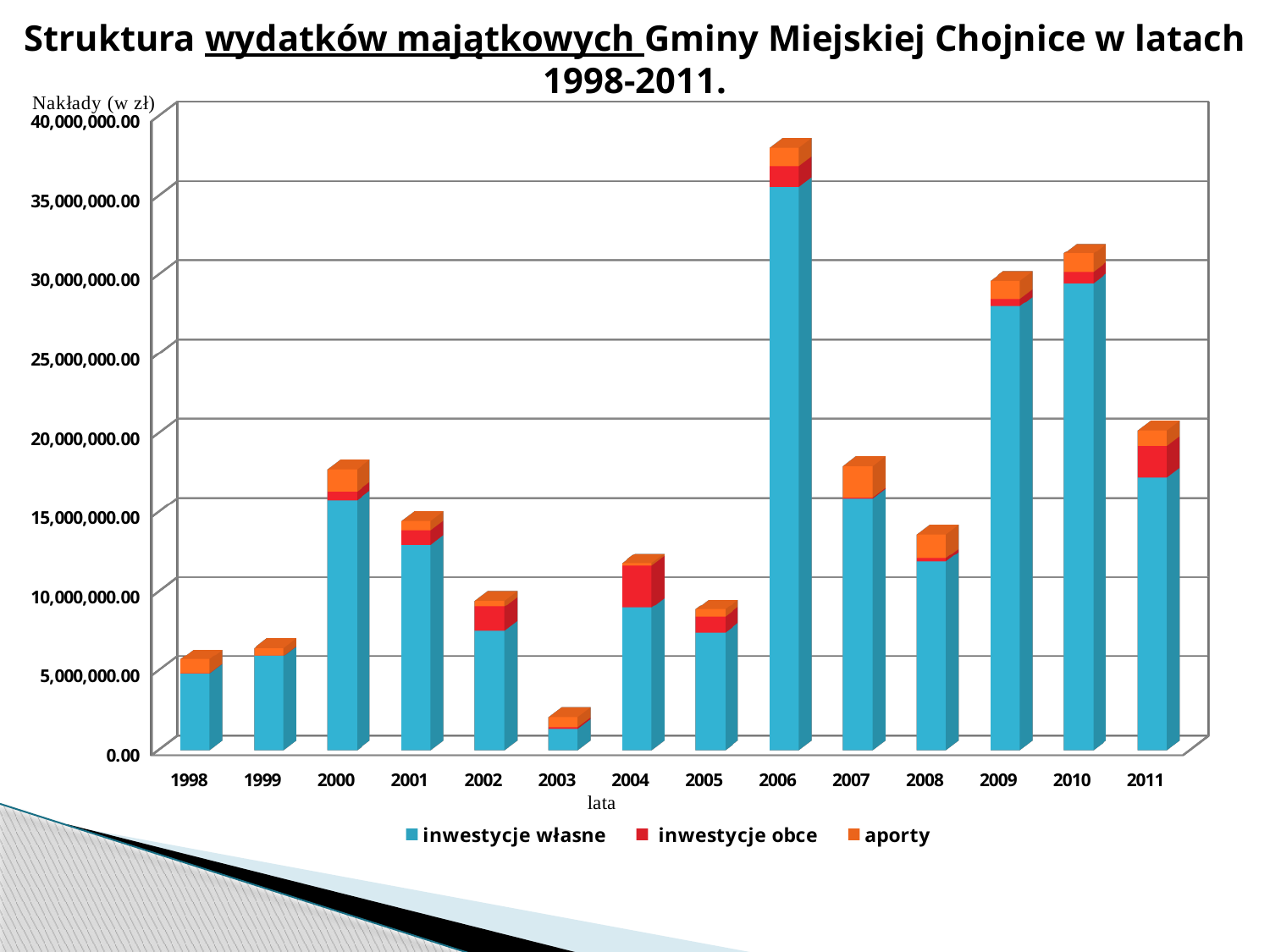
Do the total values rise or fall from 2000 to 2003? fall Which year has the highest total bar? 2006 Is the total value for 2009 greater or less than 25,000,000.00? greater How many years are shown on the x axis? 14 Which year has the lowest total bar? 2003 Is the total value for 2006 greater or less than 35,000,000.00? greater How many series does the legend list? 3 What kind of chart is shown on the slide? Stacked bar chart Which year has the larger total bar, 2000 or 2001? 2000 Is the total value for 2003 greater or less than 5,000,000.00? less What are the three series listed in the legend? inwestycje własne, inwestycje obce, aporty